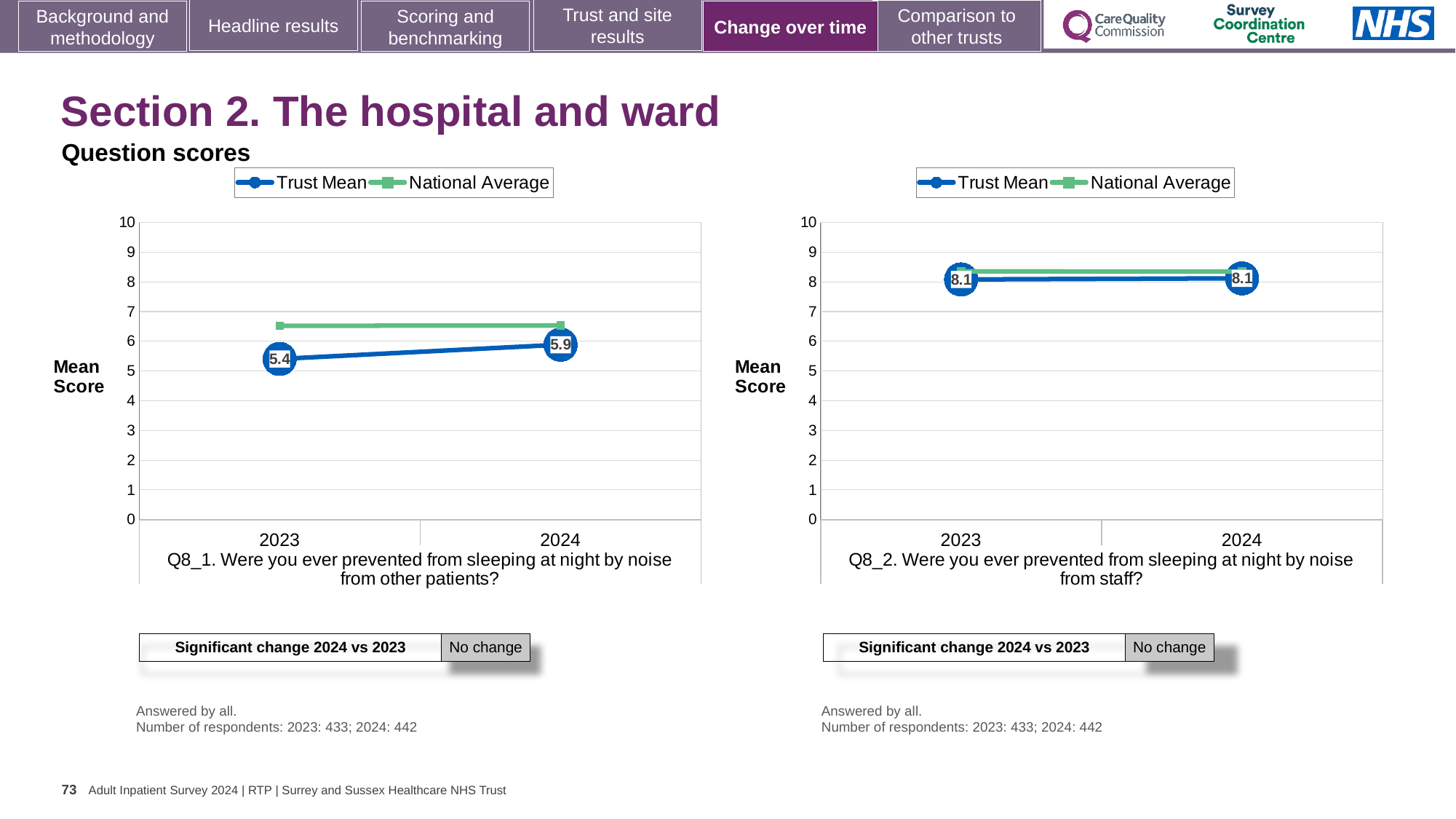
What type of chart is used for Q8_1 on the left? line chart In the left chart (Q8_1), what is the Trust Mean score for 2023? 5.4 How many series does the legend of the right chart (Q8_2) list? 2 In the right chart (Q8_2), what is the Trust Mean score for 2024? 8.1 In the left chart (Q8_1), is the National Average value for 2024 greater or less than 6? greater In the left chart (Q8_1), which series is higher in 2023, Trust Mean or National Average? National Average In the left chart (Q8_1), what is the Trust Mean score for 2024? 5.9 In the left chart (Q8_1), does the Trust Mean rise or fall from 2023 to 2024? rise In the left chart (Q8_1), by how much did the Trust Mean change from 2023 to 2024? 0.5 In the right chart (Q8_2), is the National Average value for 2023 greater or less than 7? greater In the right chart (Q8_2), does the Trust Mean rise, fall or stay the same from 2023 to 2024? stay the same How many years are plotted on the x axis of the left chart (Q8_1)? 2